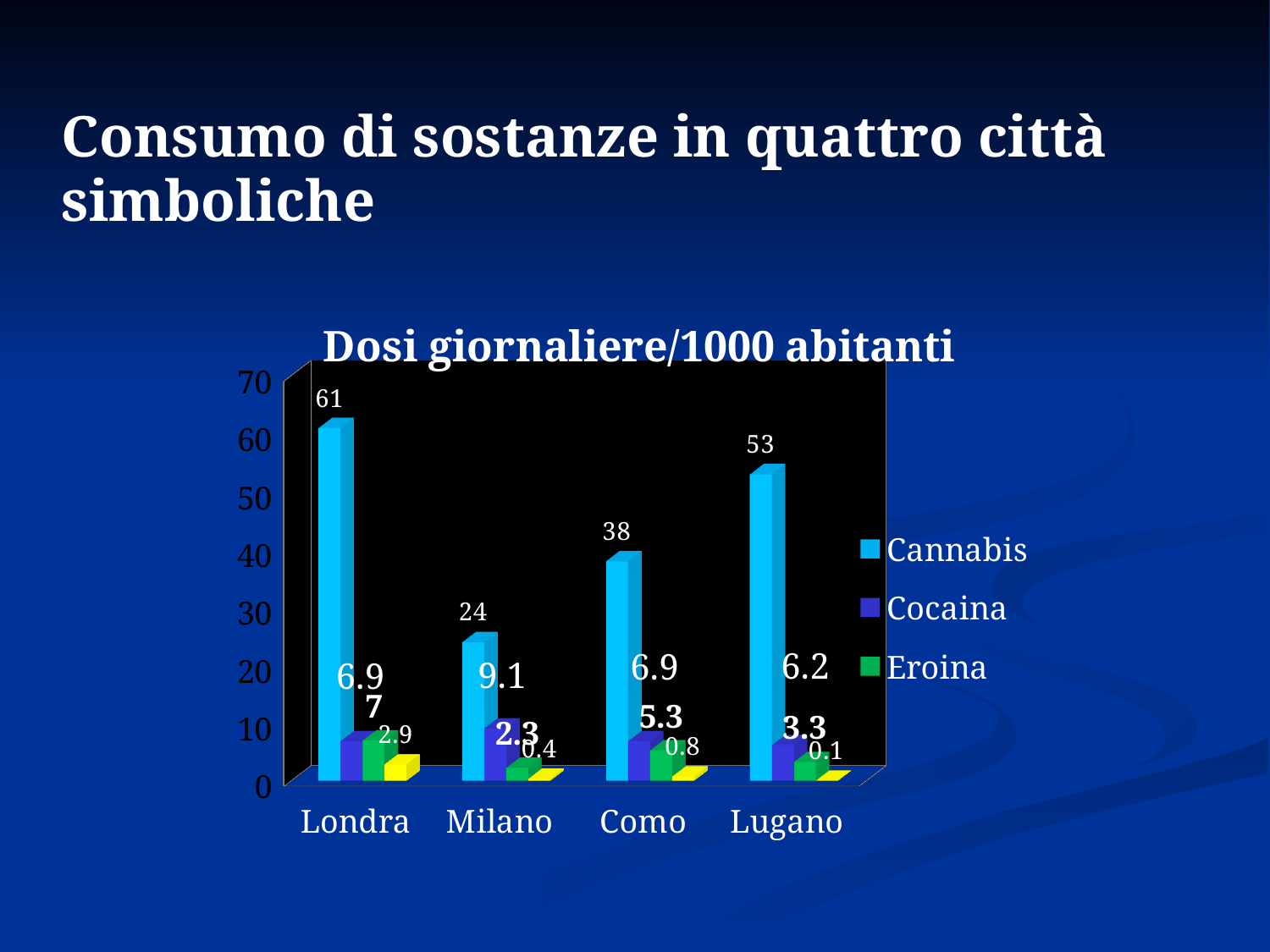
What is the Cannabis value for Londra? 61 What is the Cannabis value for Lugano? 53 Which city has the larger Cannabis value, Como or Milano? Como Which city has the lowest Cannabis value? Milano What is the difference between the Cannabis values for Londra and Lugano? 8 What is the difference between the Cannabis values for Como and Milano? 14 How many series does the legend list? 3 How many cities are shown on the x axis? 4 What is the Cannabis value for Milano? 24 What is the title of the chart? Dosi giornaliere/1000 abitanti What is the Cannabis value for Como? 38 Which city has the highest Cannabis value? Londra